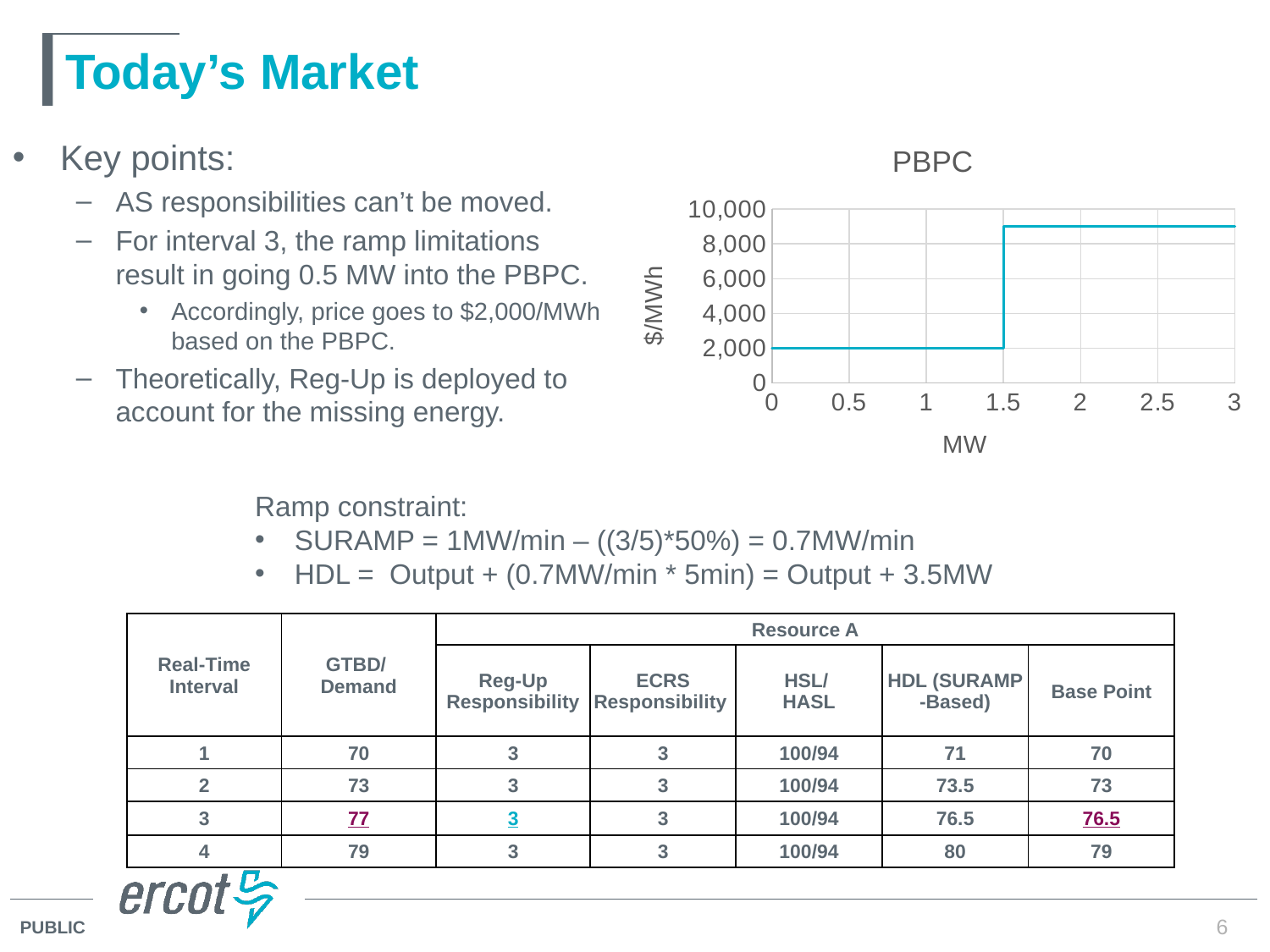
On the PBPC chart, at what MW value does the price step up? 1.5 On the PBPC chart, which is larger: the price at 0.5 MW or the price at 2.5 MW? 2.5 MW On the PBPC chart, what is the price in $/MWh at 1 MW? 2,000 On the PBPC chart, is the price at 3 MW greater or less than 6,000? greater On the PBPC chart, is the price at 1 MW greater or less than 4,000? less What is the label of the y axis on the PBPC chart? $/MWh On the PBPC chart, is the price at 2.5 MW greater or less than 10,000? less On the PBPC chart, does the price rise or fall as MW increases from 0 to 3? rise On the PBPC chart, what is the price in $/MWh at 0.5 MW? 2,000 What kind of chart is the PBPC chart? line chart What is the title of the chart on the slide? PBPC